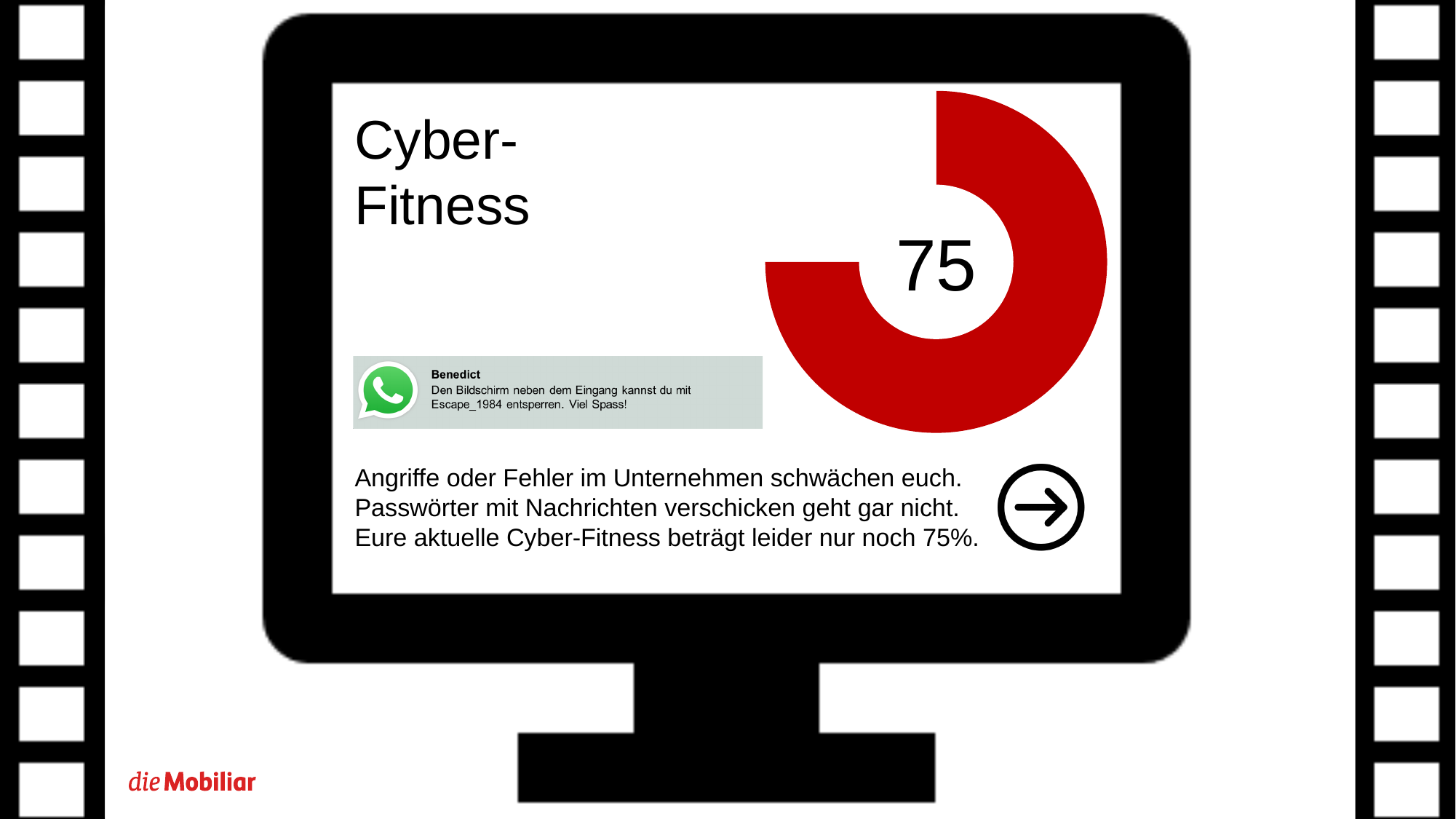
According to the slide text, what is the current Cyber-Fitness value? 75% What colour is the filled segment of the doughnut chart? red What is the title of the slide containing the doughnut chart? Cyber-Fitness What number is printed in the centre of the doughnut chart? 75 What kind of chart is shown on the slide? doughnut chart What share of the doughnut chart does the red segment cover? 75% Is the value shown by the red segment of the doughnut chart greater or less than 50? greater